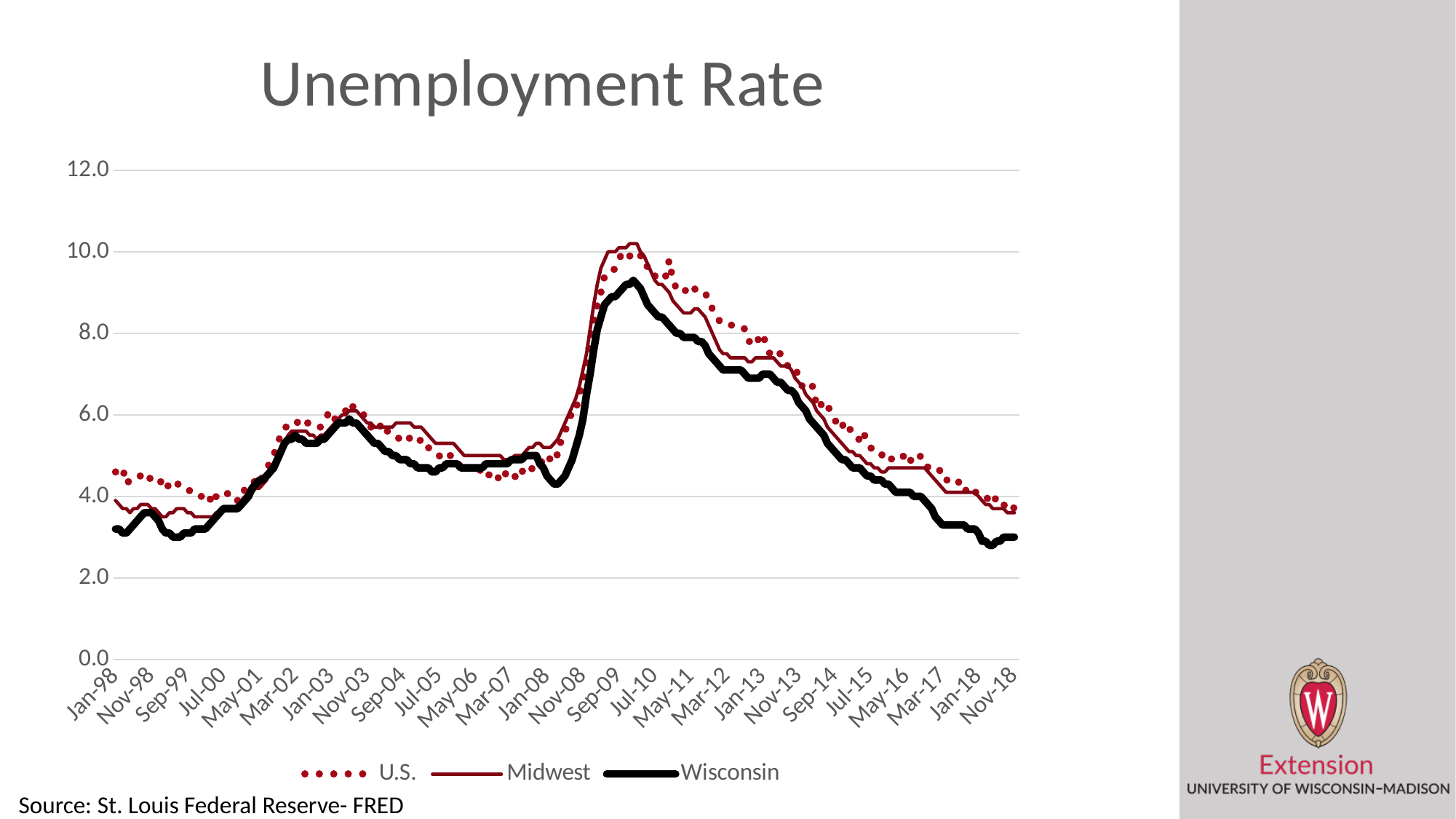
Which series has the lowest value at the peak around 2009-2010? Wisconsin What kind of chart is shown on the slide? line chart Do the values for all three series rise or fall from Sep-09 to Nov-18? fall How many series does the legend list? 3 What is the title of the chart? Unemployment Rate Which series is drawn as a dotted line? U.S. Which series has the lowest value at Nov-18? Wisconsin What source is cited below the chart? St. Louis Federal Reserve- FRED Is the value for Wisconsin at Jan-98 greater or less than 4.0? less Is the value for Wisconsin at Nov-18 greater or less than 4.0? less Is the value for U.S. at Jan-98 greater or less than 4.0? greater